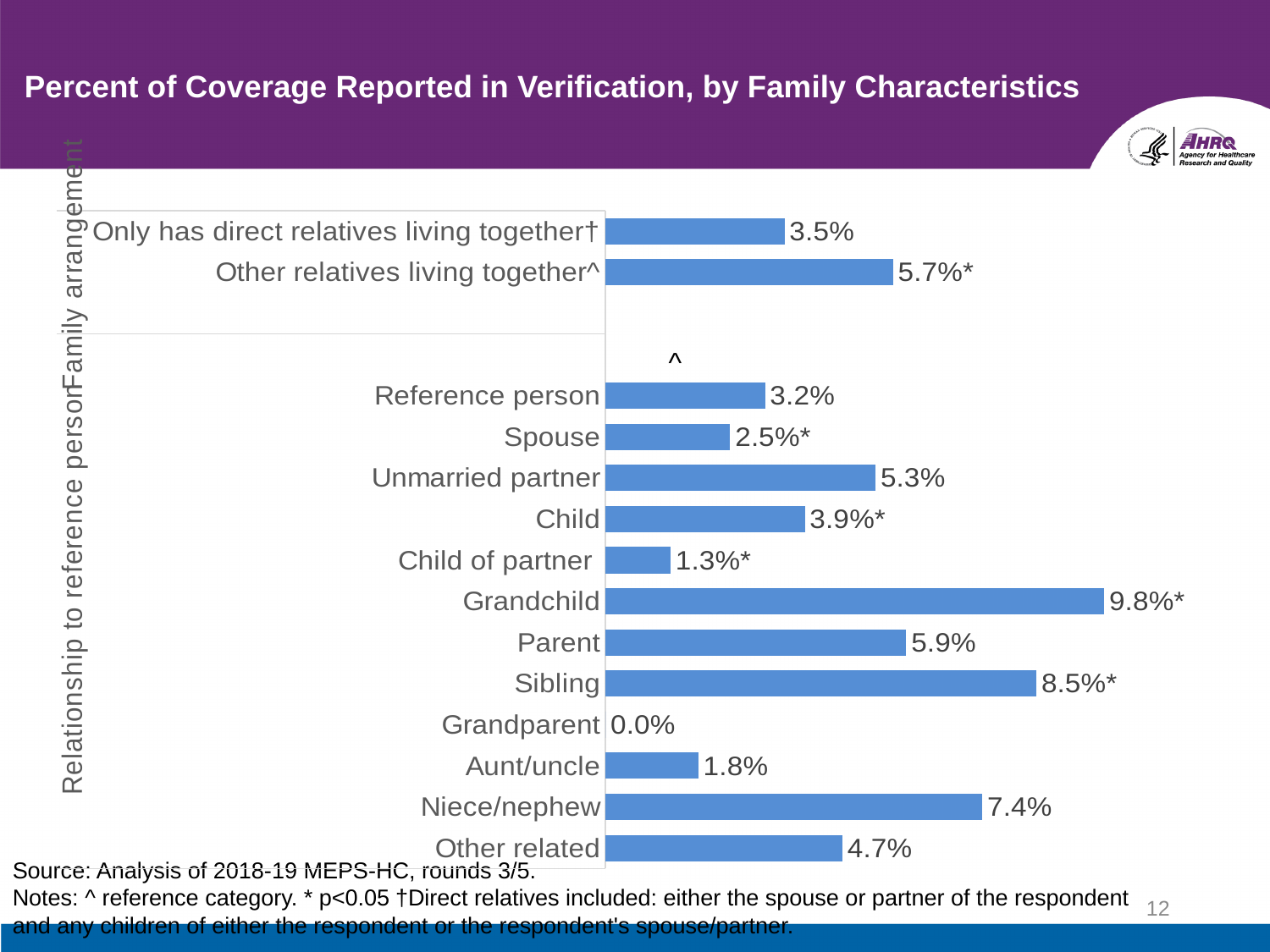
How many categories are plotted in the chart? 14 What is the difference between the values for Grandchild and Sibling? 1.3 percentage points What is the value for Niece/nephew? 7.4% Which is larger, the value for Spouse or the value for Reference person? Reference person Which is larger, the value for Parent or the value for Unmarried partner? Parent What is the value for Grandchild? 9.8%* What kind of chart is shown on the slide? Bar chart Which category has the lowest value? Grandparent What is the difference between the values for Niece/nephew and Aunt/uncle? 5.6 percentage points What is the value for Child of partner? 1.3%* Which category has the highest value? Grandchild What is the value for Other relatives living together^? 5.7%*